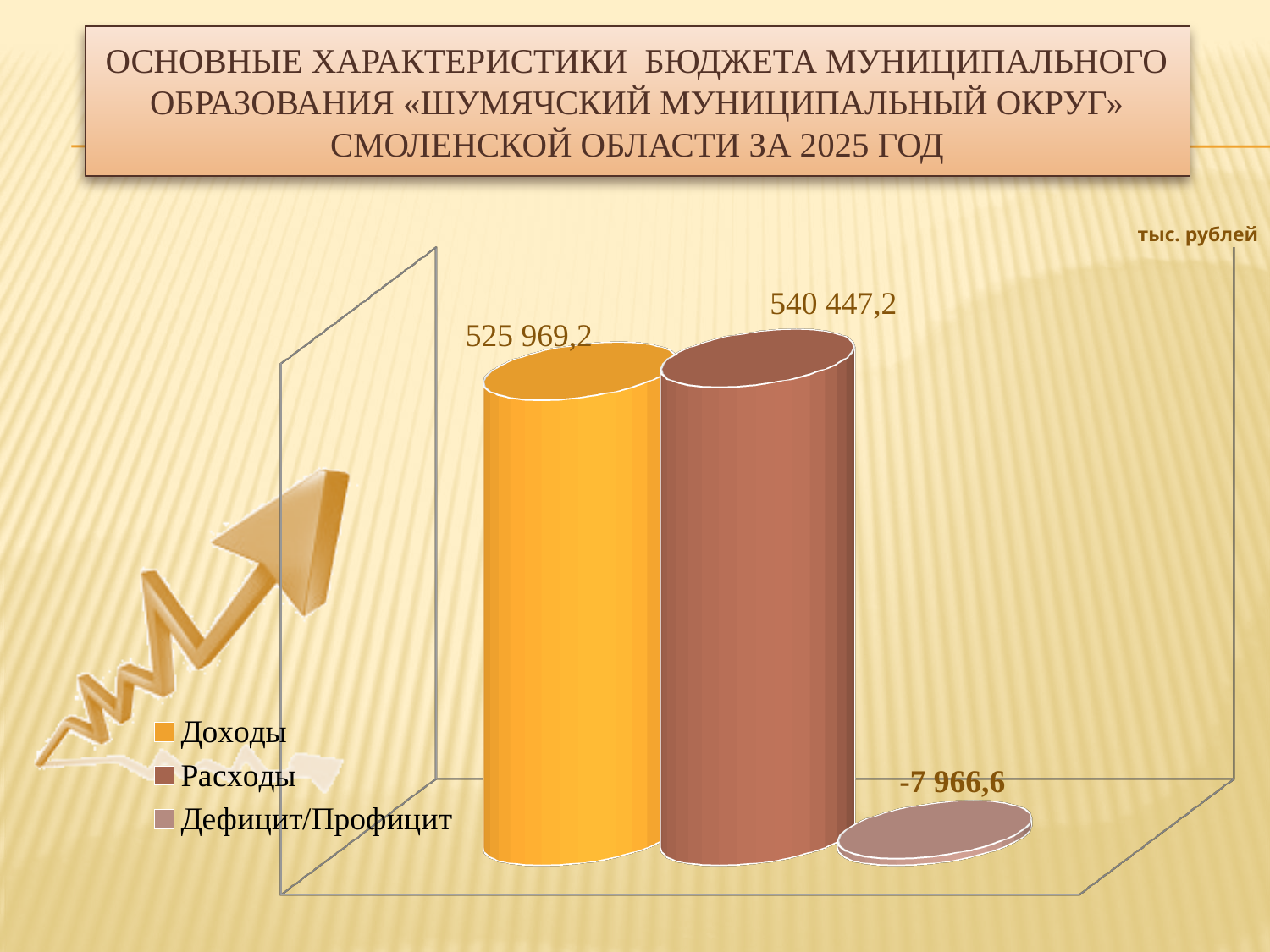
How many series does the legend list? 3 What is the value for Расходы? 540 447,2 How many bars are plotted on the chart? 3 What unit of measurement is indicated for the chart values? тыс. рублей What is the difference between Расходы and Доходы? 14 478,0 Which series has the highest value? Расходы Which series has the lowest value? Дефицит/Профицит Which is larger, Доходы or Расходы? Расходы What is the value for Доходы? 525 969,2 What colour is the bar for Доходы? Orange/yellow What is the value for Дефицит/Профицит? -7 966,6 What kind of chart is shown on the slide? Bar chart